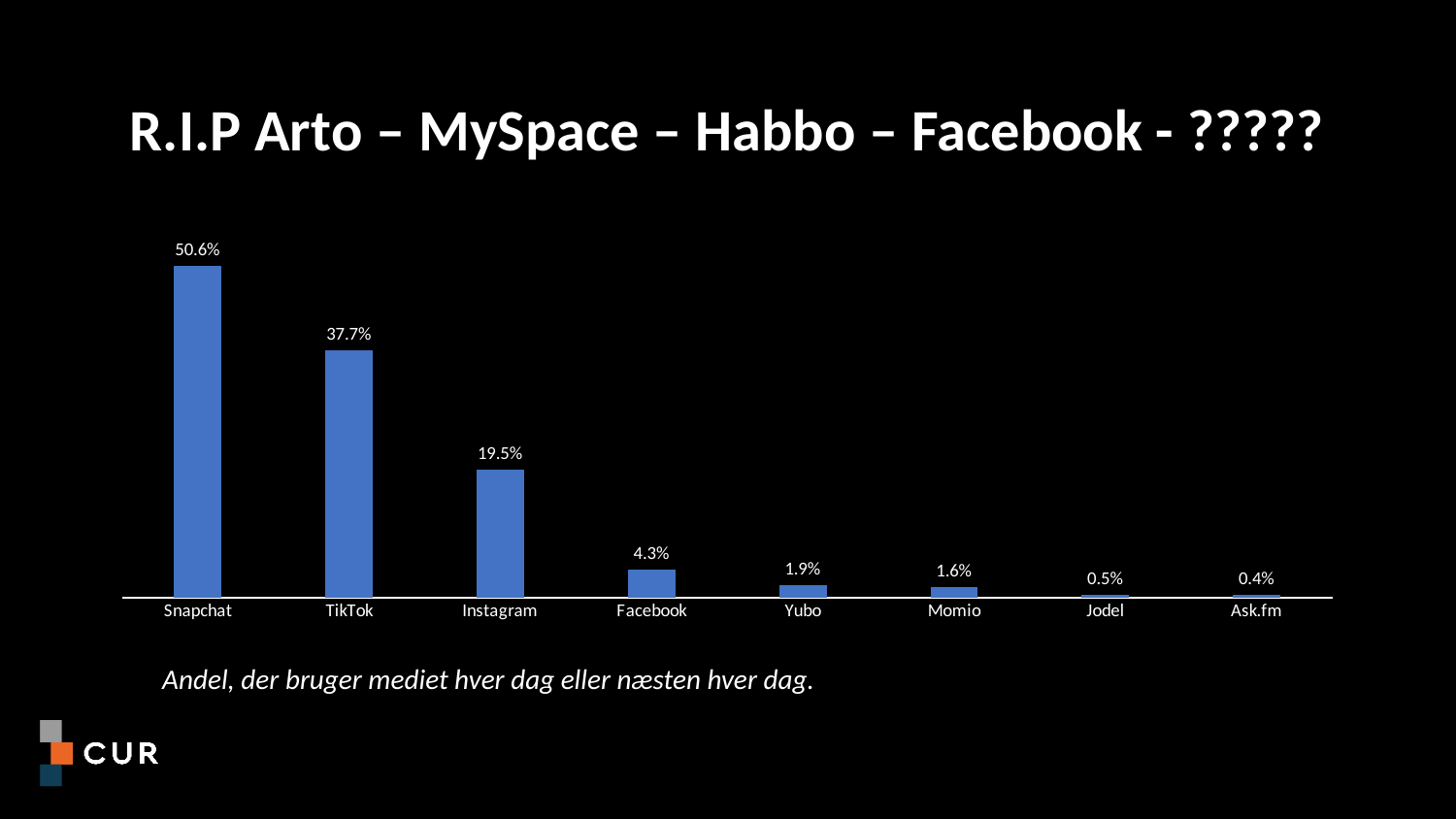
Do the values rise or fall from left to right along the x axis? Fall What is the value for Instagram? 19.5% What is the difference between the values for Snapchat and TikTok? 12.9% How many categories are shown on the chart? 8 What is the value for TikTok? 37.7% Which is larger, the value for Yubo or the value for Momio? Yubo What kind of chart is shown on the slide? Bar chart Which category has the highest value? Snapchat Which category has the lowest value? Ask.fm What is the value for Momio? 1.6% What is the value for Facebook? 4.3% What is the value for Snapchat? 50.6%